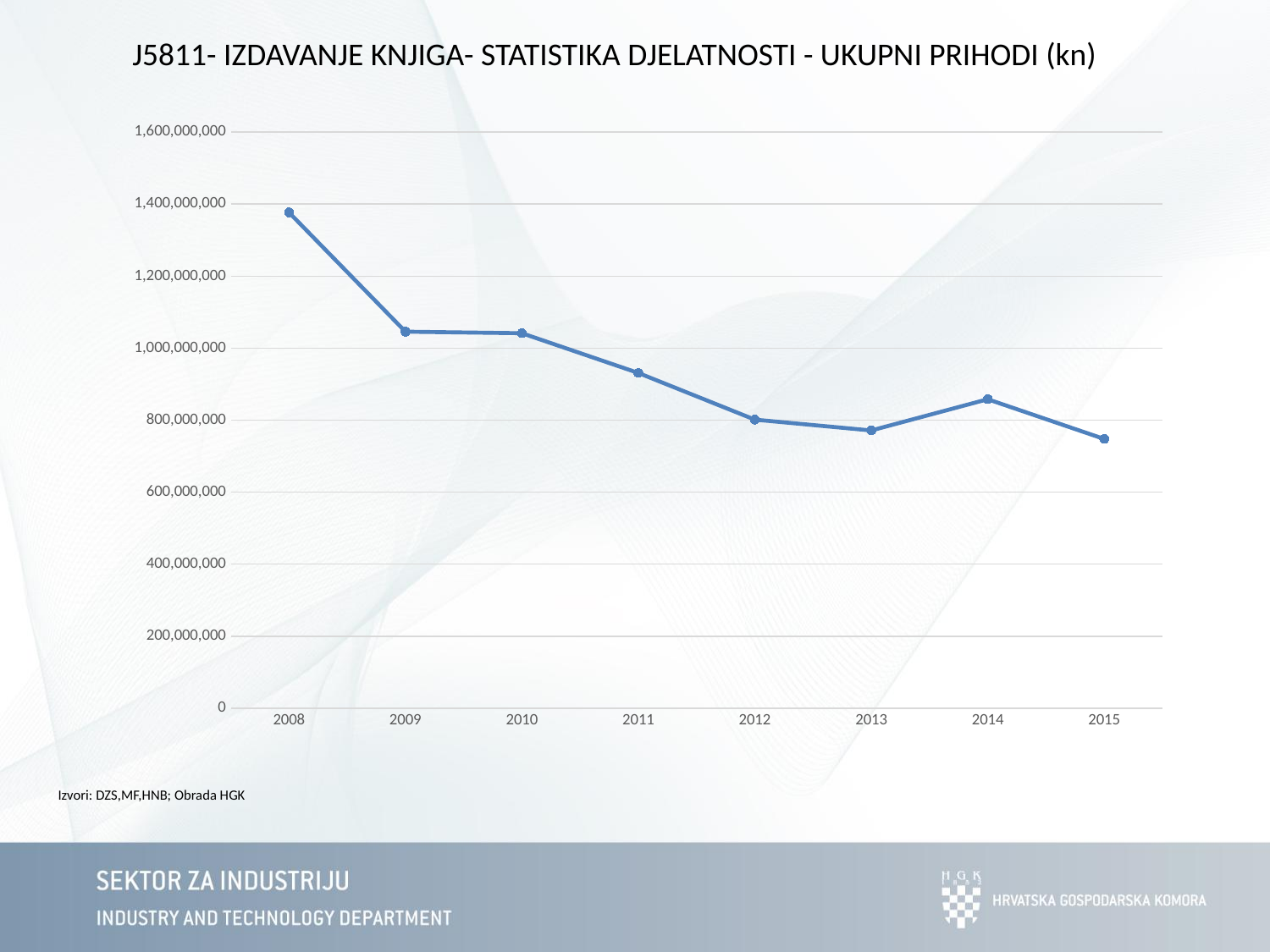
Do the values generally rise or fall from 2008 to 2015? fall Is the value for 2014 greater or less than 800,000,000? greater Is the value for 2013 greater or less than 800,000,000? less Is the value for 2011 greater or less than 1,000,000,000? less Which year has the larger value, 2013 or 2014? 2014 What is the title of the chart? J5811- IZDAVANJE KNJIGA- STATISTIKA DJELATNOSTI - UKUPNI PRIHODI (kn) Which year has the highest total revenue (ukupni prihodi)? 2008 How many years (data points) are plotted on the chart? 8 What kind of chart is shown on the slide? line chart Which year has the lowest total revenue (ukupni prihodi)? 2015